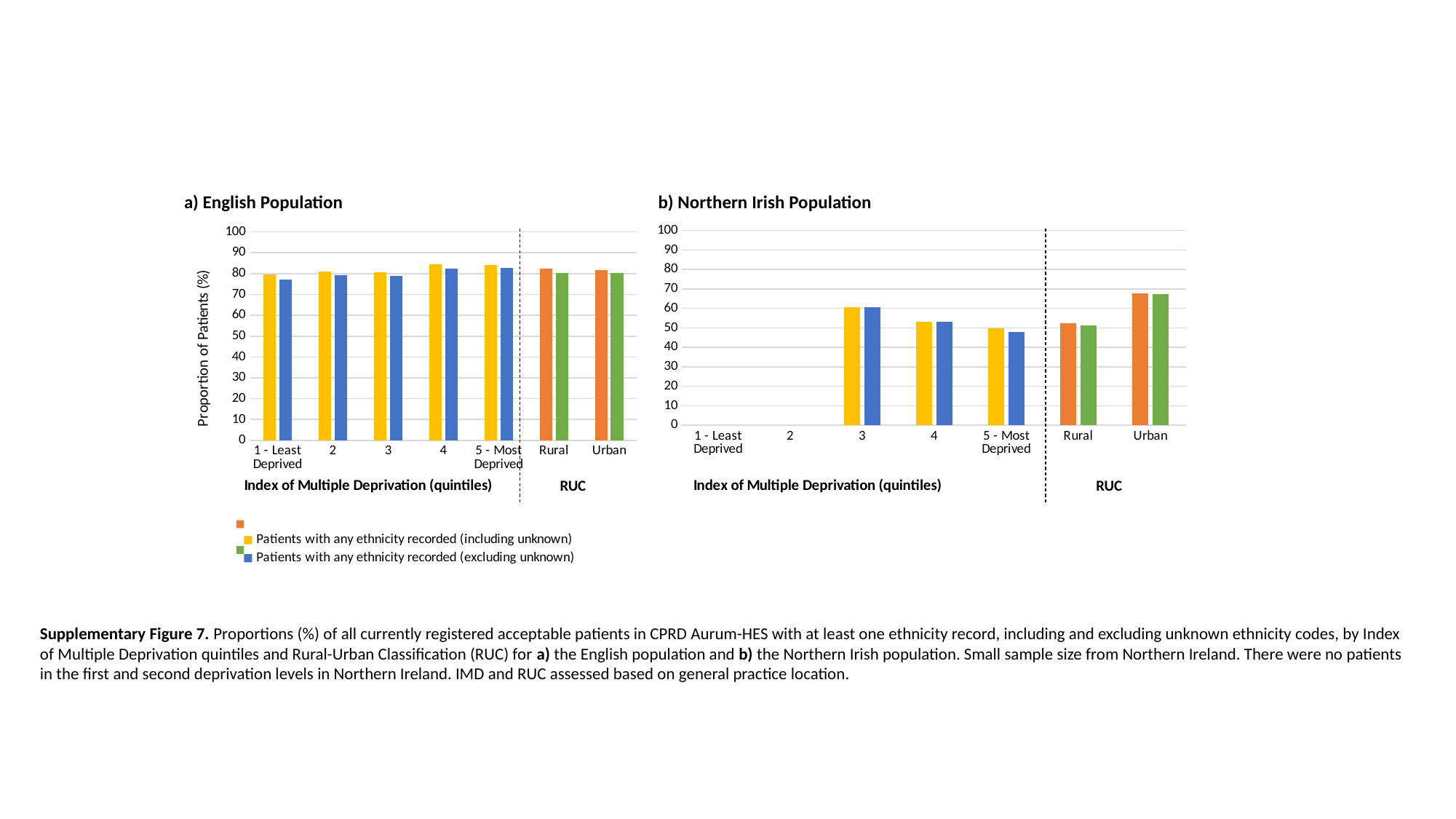
In the Northern Irish Population chart, which is larger for patients with any ethnicity recorded (including unknown): quintile 3 or quintile 4? Quintile 3 In the Northern Irish Population chart, is the value for quintile 3 (including unknown) greater or less than 50? greater In the Northern Irish Population chart, which is larger for patients with any ethnicity recorded (excluding unknown): Rural or Urban? Urban What kind of chart is used for the English Population panel? Bar chart In the Northern Irish Population chart, is the value for Urban (including unknown) greater or less than 60? greater In the Northern Irish Population chart, which category has the highest values? Urban How many series does the legend list? 2 What is the y-axis label of the English Population chart? Proportion of Patients (%) In the Northern Irish Population chart, is the value for quintile 4 (excluding unknown) greater or less than 40? greater In the Northern Irish Population chart, do the values rise or fall from quintile 3 to 5 - Most Deprived? Fall In the English Population chart, how many categories are shown on the x axis? 7